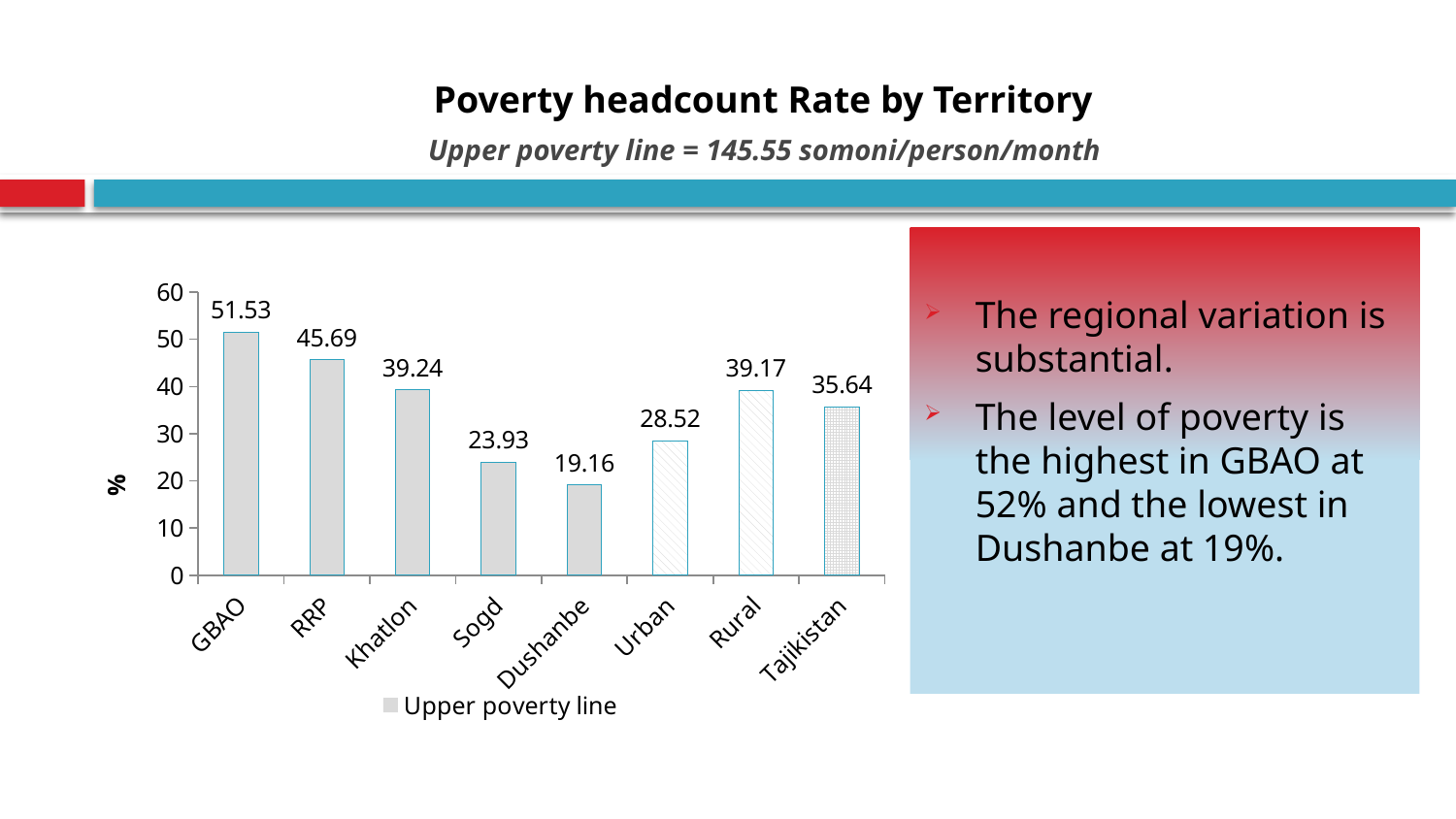
What type of chart is shown on the slide? Bar chart Which territory has the lowest poverty headcount rate? Dushanbe Which has a higher poverty headcount rate, RRP or Khatlon? RRP What is the legend entry shown below the chart? Upper poverty line What is the poverty headcount rate for Dushanbe? 19.16 What is the difference between the poverty headcount rates of Rural and Urban? 10.65 What is the poverty headcount rate for Tajikistan as a whole? 35.64 Is the value for Sogd greater or less than 30? less What is the difference between the poverty headcount rates of GBAO and Dushanbe? 32.37 How many territories are shown on the x axis of the chart? 8 What is the poverty headcount rate for GBAO? 51.53 Which territory has the highest poverty headcount rate? GBAO